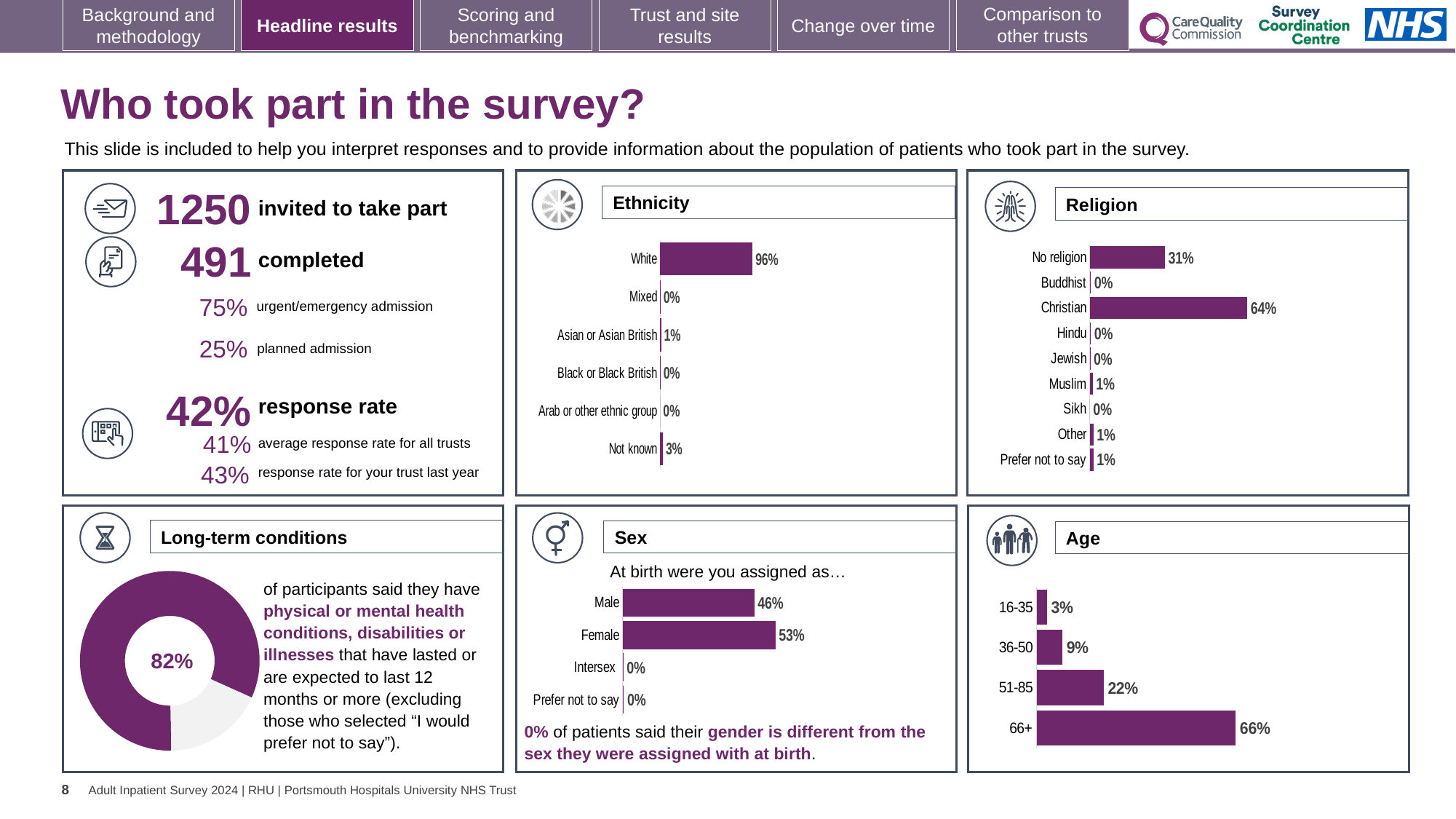
In the Sex chart, what is the value for Male? 46% In the Age chart, what is the value for 51-85? 22% In the Religion chart, what is the value for No religion? 31% How many categories are shown in the Ethnicity chart? 6 In the Ethnicity chart, what percentage of respondents were White? 96% In the Sex chart, which is larger, Male or Female? Female In the Religion chart, what is the difference between Christian and No religion? 33% In the Age chart, do the values rise or fall as age increases from 16-35 to 66+? rise In the Religion chart, which category has the highest value? Christian In the Age chart, which age group has the lowest value? 16-35 In the Long-term conditions chart, what share of participants said they have long-term conditions? 82% What kind of chart is the Long-term conditions chart? doughnut chart